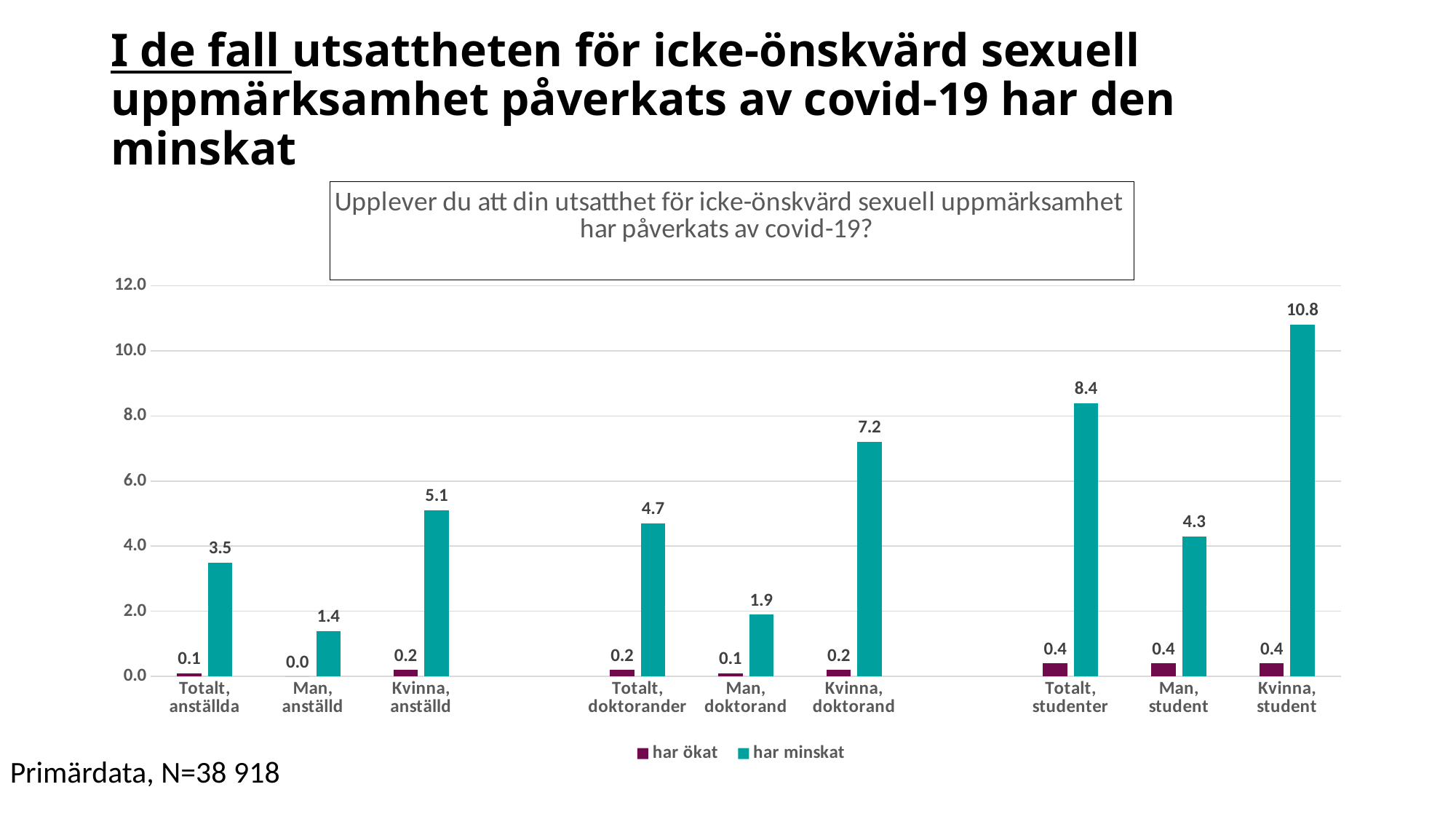
Which is larger: the "har minskat" value for Kvinna, doktorand or for Kvinna, anställd? Kvinna, doktorand How many series does the legend list? 2 What kind of chart is shown on the slide? Bar chart What is the value of "har minskat" for Kvinna, student? 10.8 Which category has the lowest "har minskat" value? Man, anställd What is the difference between the "har minskat" values for Kvinna, student and Totalt, studenter? 2.4 How many categories are shown on the x axis? 9 Which category has the highest "har minskat" value? Kvinna, student What are the two legend entries of the chart? har ökat, har minskat What is the value of "har minskat" for Totalt, doktorander? 4.7 What is the value of "har ökat" for Man, anställd? 0.0 What is the value of "har ökat" for Totalt, studenter? 0.4